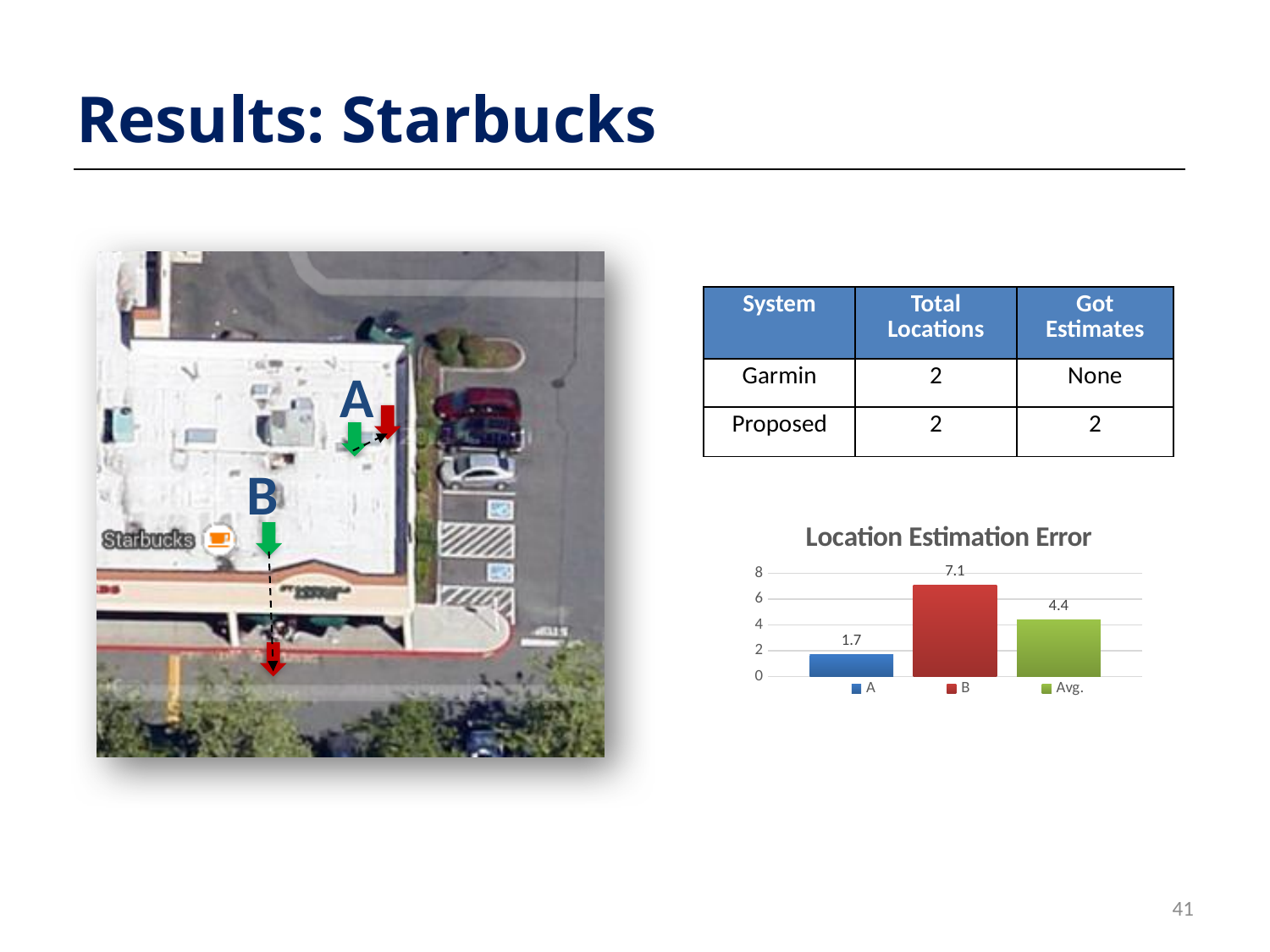
Which bar has the lowest value in the Location Estimation Error chart? A How many entries does the legend of the Location Estimation Error chart list? 3 Is the value for B greater or less than 6? greater What is the location estimation error for B? 7.1 Which bar has the highest value in the Location Estimation Error chart? B What is the title of the chart on the slide? Location Estimation Error Which is larger, the error for B or the Avg. error? B How many bars are shown in the Location Estimation Error chart? 3 What is the location estimation error for A? 1.7 What is the value of the Avg. bar in the Location Estimation Error chart? 4.4 What type of chart is the Location Estimation Error chart? bar chart What is the difference between the error for B and the error for A? 5.4